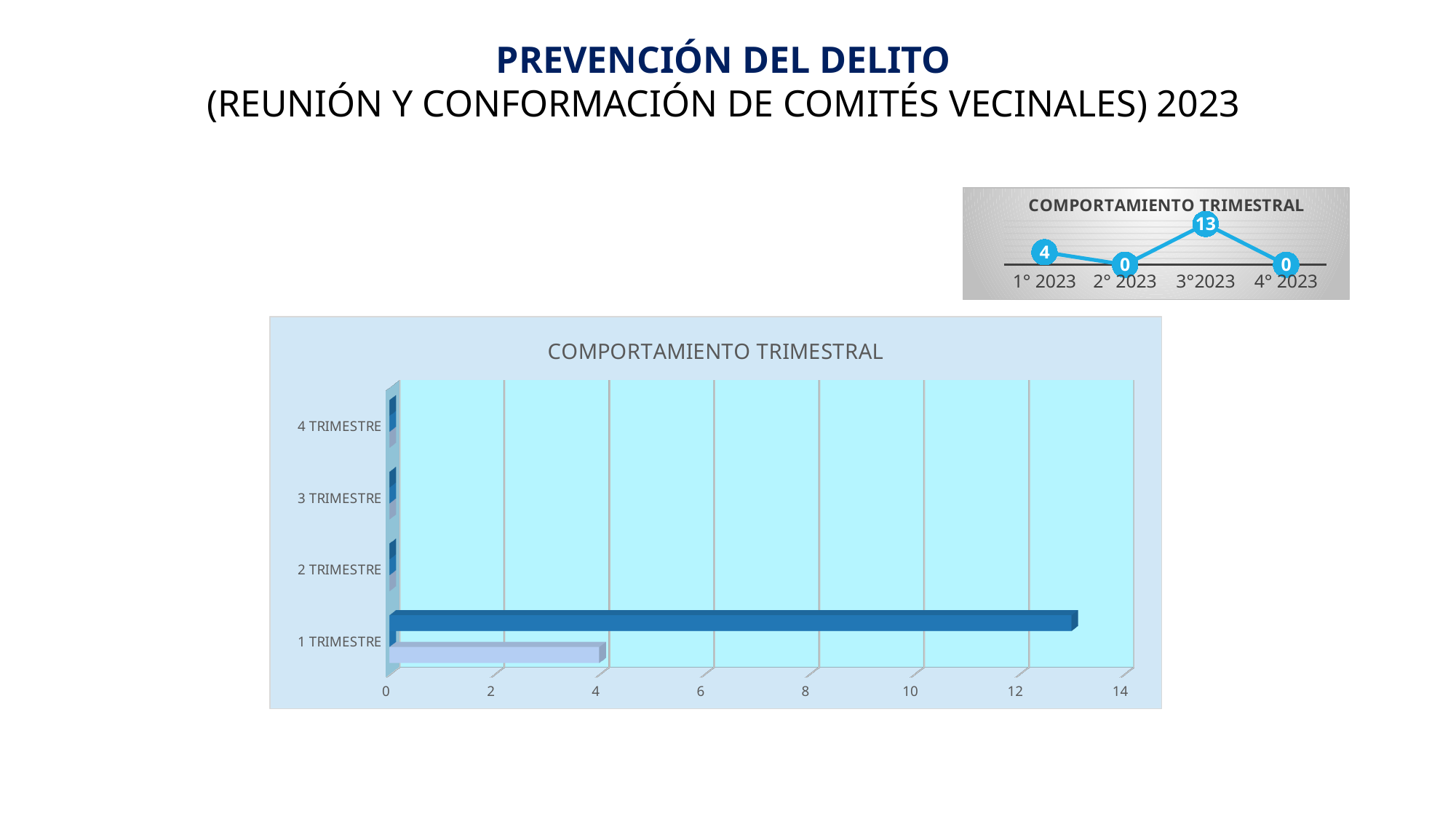
In the small line chart at the top right, what is the value for 3°2023? 13 What is the title of the large bar chart? COMPORTAMIENTO TRIMESTRAL In the small line chart at the top right, what is the value for 1° 2023? 4 What kind of chart is the large chart in the lower part of the slide? Bar chart In the small line chart at the top right, what is the difference between the values for 3°2023 and 1° 2023? 9 In the small line chart at the top right, which is larger, the value for 1° 2023 or the value for 2° 2023? 1° 2023 How many data points are plotted in the small line chart at the top right? 4 What kind of chart is the small chart at the top right of the slide? Line chart In the large bar chart, how many categories are shown on the vertical axis? 4 In the large bar chart, is the value of the longer (dark blue) bar for 1 TRIMESTRE greater or less than 12? greater In the small line chart at the top right, what is the value for 4° 2023? 0 In the small line chart at the top right, which period has the highest value? 3°2023